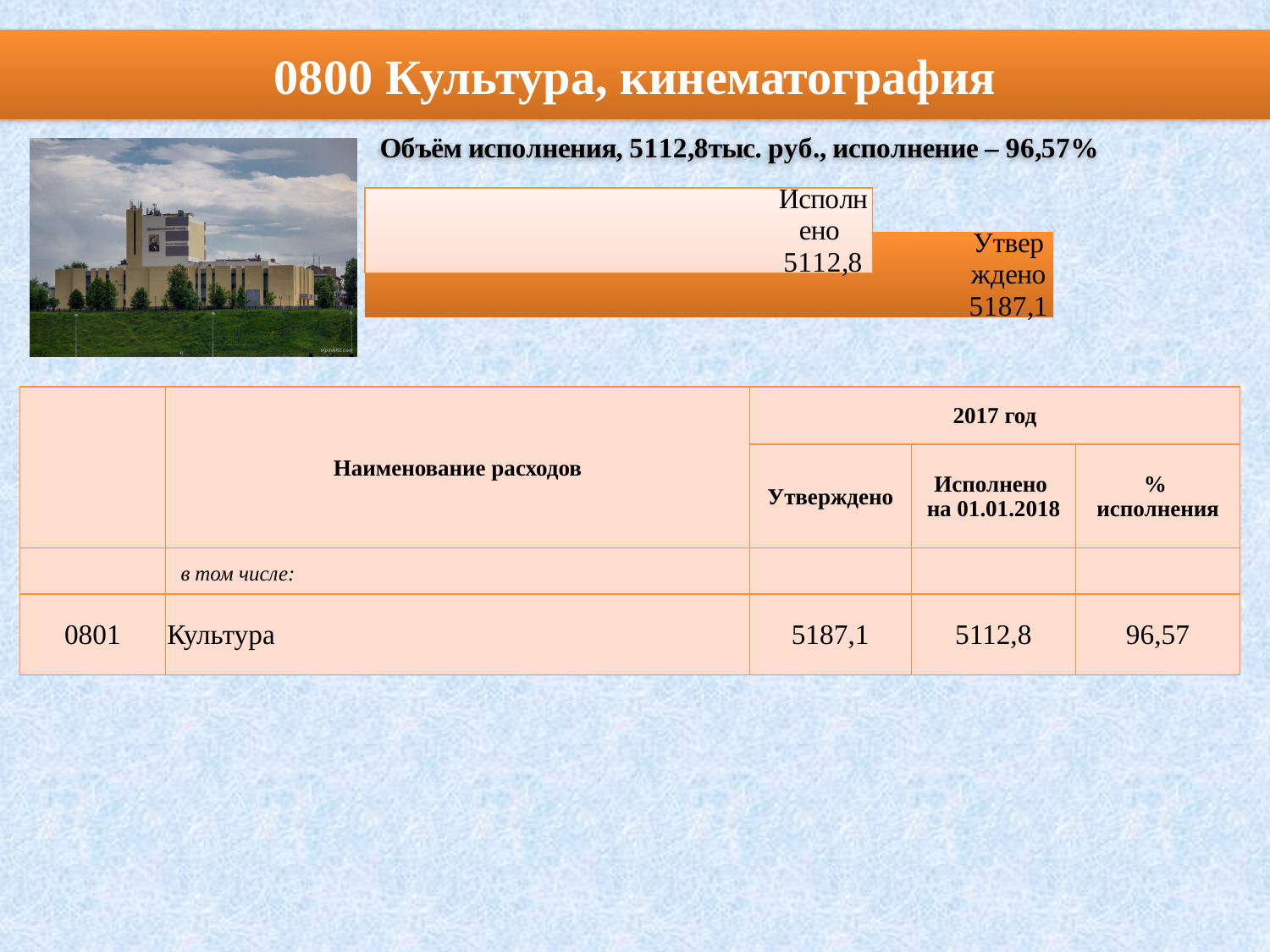
Which bar in the chart is drawn in the darker orange colour? Утверждено Which bar in the chart has the higher value? Утверждено What kind of chart is shown on the slide? bar chart Which bar in the chart has the lower value? Исполнено Are the bars in the chart horizontal or vertical? horizontal What is the difference between the "Утверждено" and "Исполнено" values in the chart? 74,3 How many bars are plotted in the chart? 2 What value is shown for the "Исполнено" bar in the chart? 5112,8 Is the value for "Исполнено" larger or smaller than the value for "Утверждено" in the chart? smaller What value is shown for the "Утверждено" bar in the chart? 5187,1